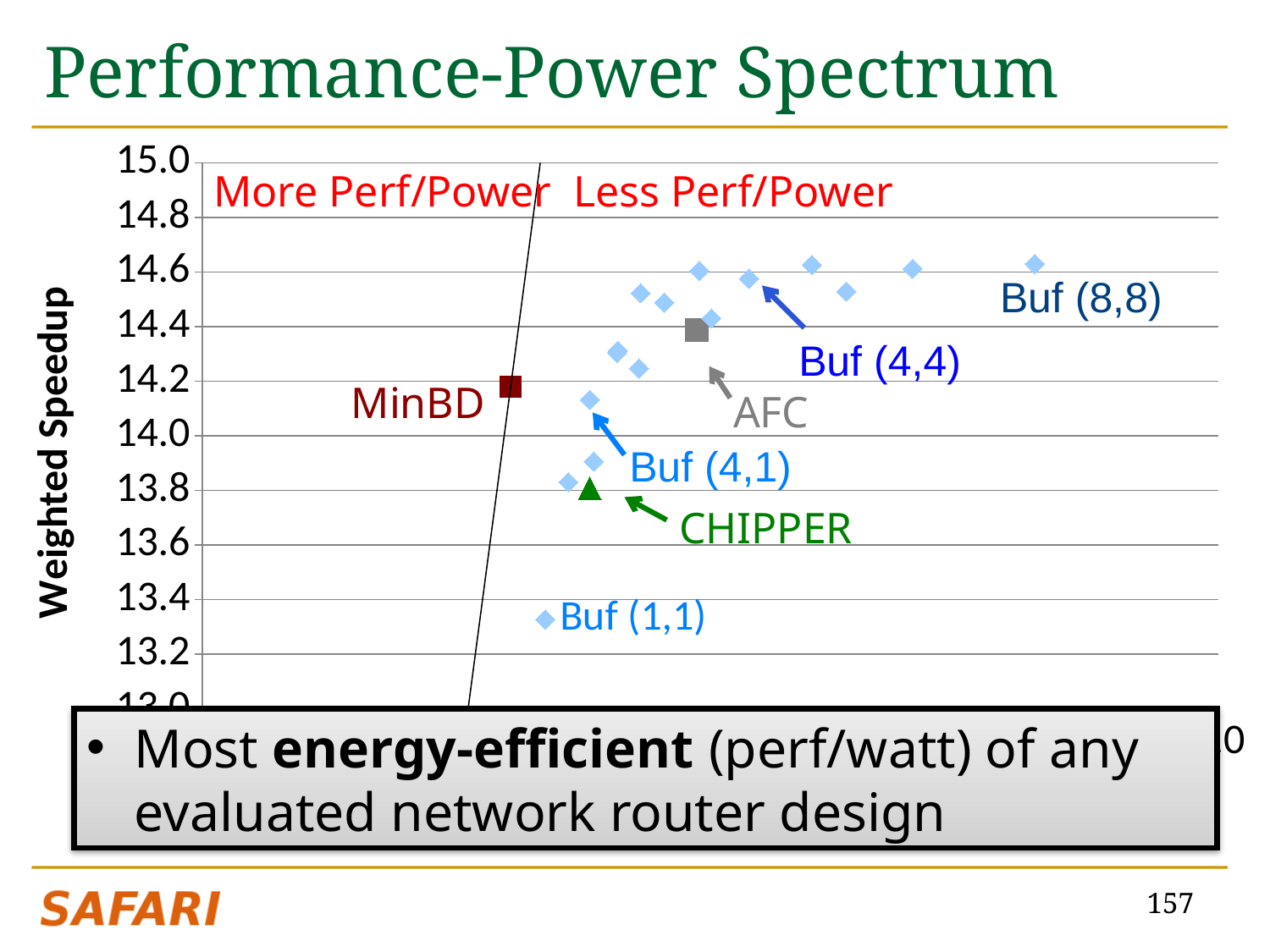
Is the Weighted Speedup for Buf (8,8) greater or less than 14.4? greater Is the Weighted Speedup for MinBD greater or less than 14.0? greater Which side of the diagonal line is labeled "More Perf/Power"? the left side Is the Weighted Speedup for AFC greater or less than 14.2? greater Which has a higher Weighted Speedup, MinBD or CHIPPER? MinBD Which has a higher Weighted Speedup, Buf (8,8) or Buf (1,1)? Buf (8,8) What is the label of the y axis? Weighted Speedup Which labeled design has the lowest Weighted Speedup? Buf (1,1) What kind of chart is shown on the slide? scatter chart Which has a higher Weighted Speedup, AFC or MinBD? AFC